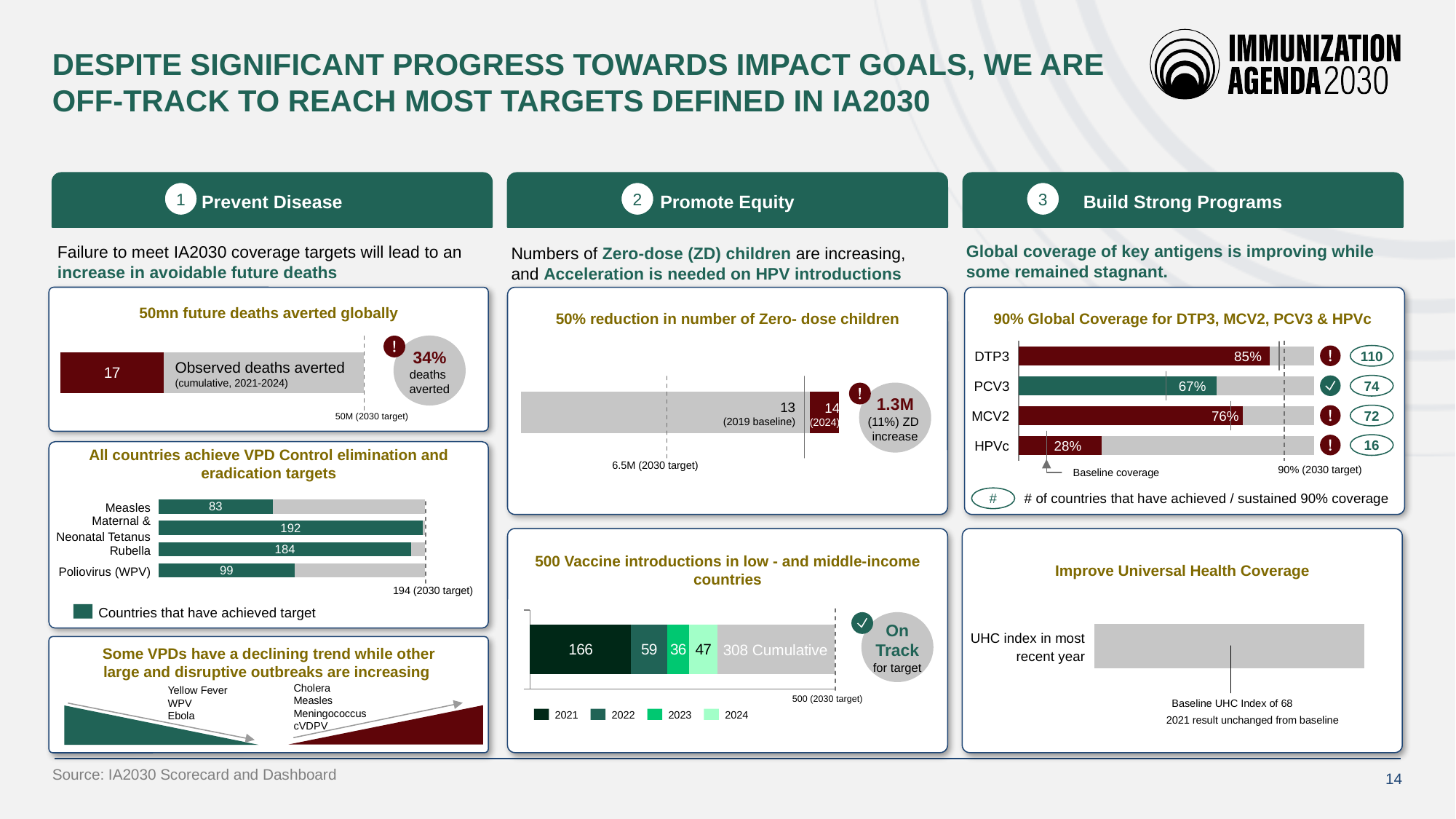
In the '90% Global Coverage for DTP3, MCV2, PCV3 & HPVc' chart, what is the coverage for MCV2? 76% In the '90% Global Coverage for DTP3, MCV2, PCV3 & HPVc' chart, which antigen has the lowest coverage? HPVc In the '500 Vaccine introductions in low- and middle-income countries' chart, what is the value for 2022? 59 In the '500 Vaccine introductions in low- and middle-income countries' chart, what is the cumulative total of the stacked bar? 308 In the 'All countries achieve VPD Control elimination and eradication targets' chart, which disease has the lowest number of countries that have achieved the target? Measles In the '50% reduction in number of Zero-dose children' chart, what is the 2024 value? 14 In the 'All countries achieve VPD Control elimination and eradication targets' chart, how many countries have achieved the target for Measles? 83 In the '90% Global Coverage for DTP3, MCV2, PCV3 & HPVc' chart, how many countries have achieved / sustained 90% coverage for PCV3? 74 In the 'All countries achieve VPD Control elimination and eradication targets' chart, what is the difference between the values for Rubella and Poliovirus (WPV)? 85 In the '90% Global Coverage for DTP3, MCV2, PCV3 & HPVc' chart, which has higher coverage, DTP3 or PCV3? DTP3 In the 'All countries achieve VPD Control elimination and eradication targets' chart, which disease has the highest number of countries that have achieved the target? Maternal & Neonatal Tetanus In the '500 Vaccine introductions in low- and middle-income countries' chart, how many series does the legend list? 4